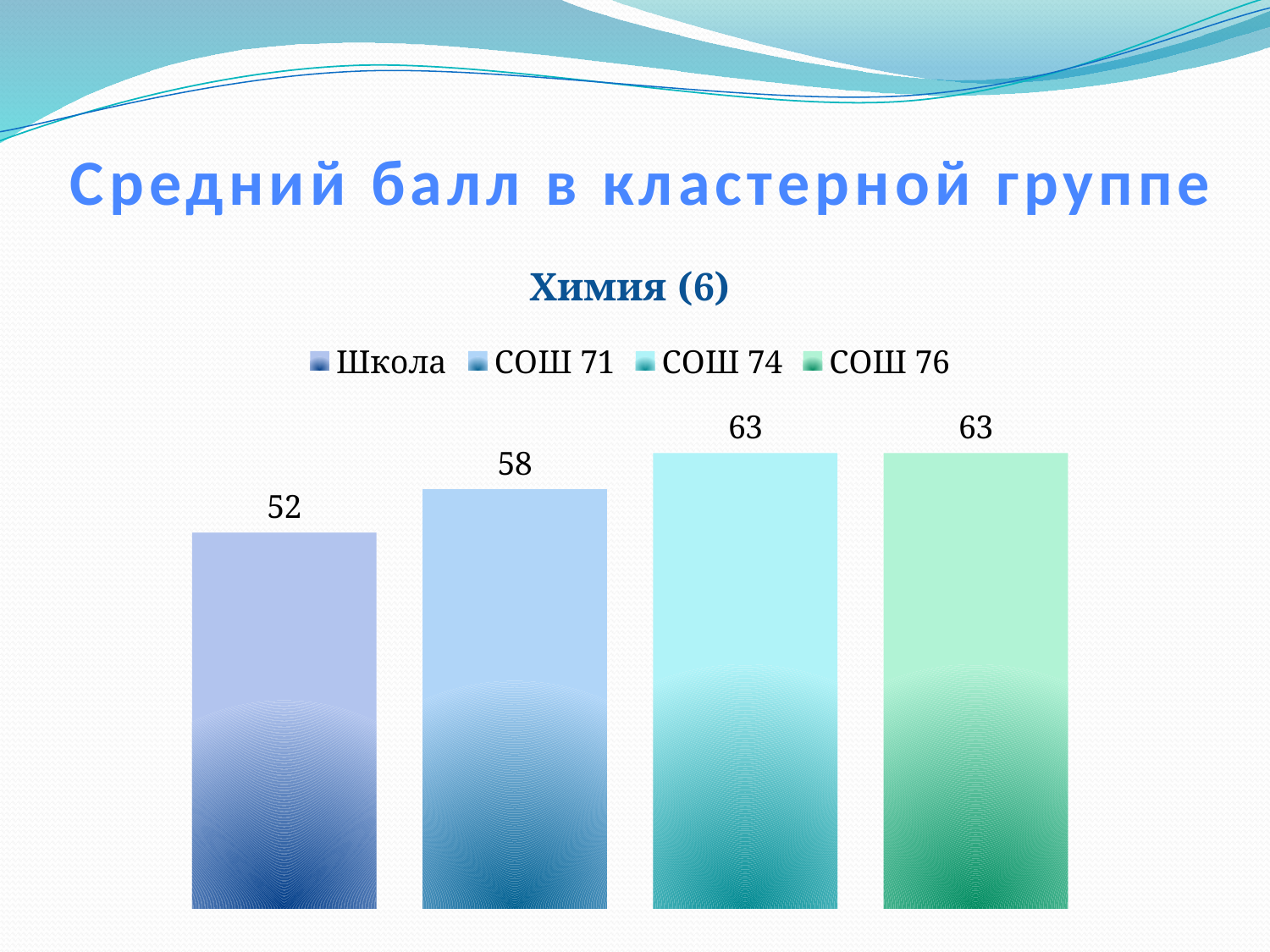
What kind of chart is shown on the slide? Bar chart What is the title of the chart? Химия (6) How many bars are plotted in the chart? 4 What is the difference between the values for СОШ 74 and Школа? 11 How many series does the legend list? 4 What is the value for СОШ 76 in the chart? 63 Which is larger, the value for СОШ 71 or the value for Школа? СОШ 71 What is the value for СОШ 71 in the chart? 58 What is the difference between the values for СОШ 71 and Школа? 6 What is the value for СОШ 74 in the chart? 63 Which series has the lowest value in the chart? Школа What is the value for Школа in the chart? 52